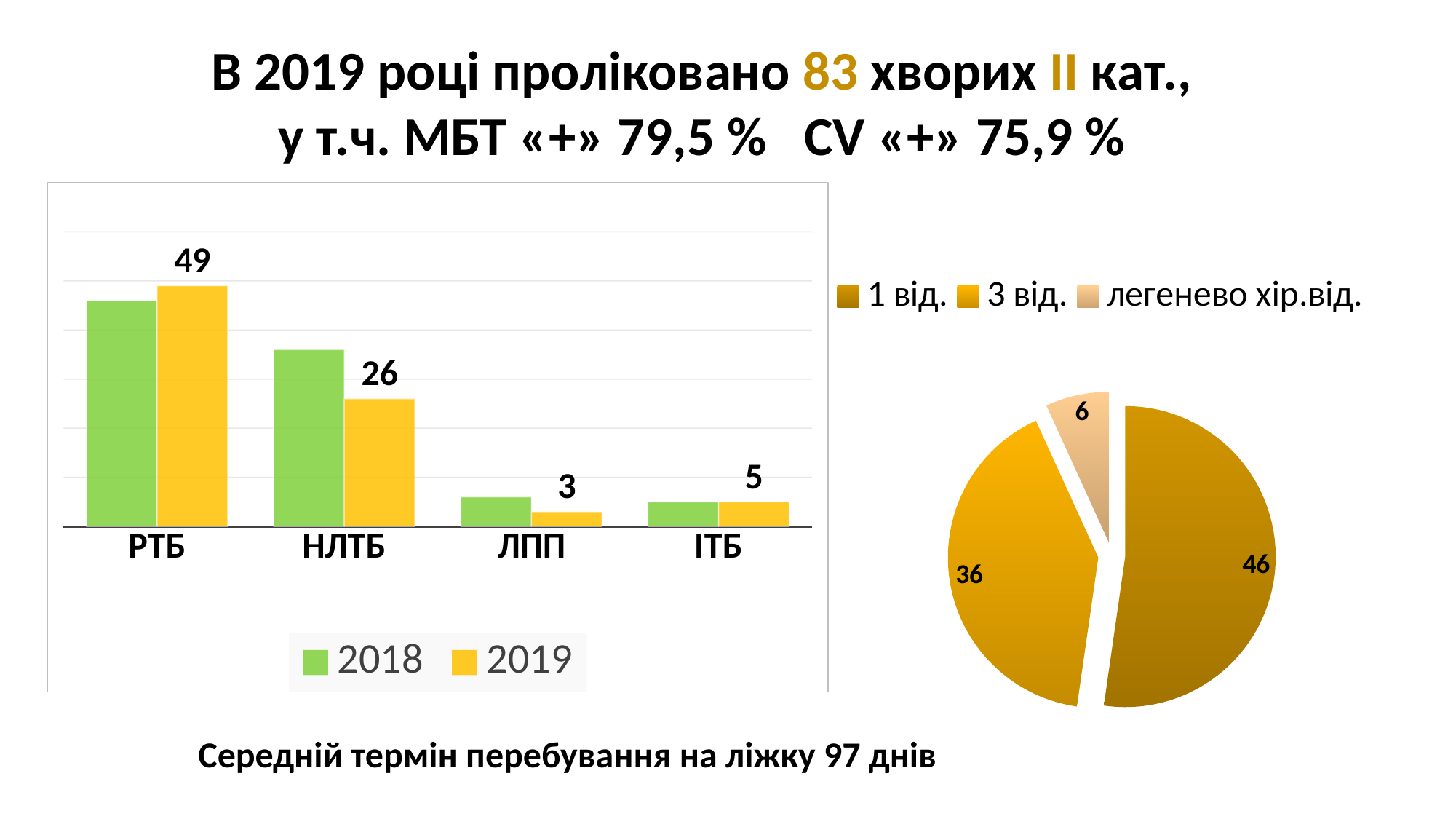
In the bar chart on the left, what is the 2019 value for ЛПП? 3 In the pie chart on the right, what is the value for 3 від.? 36 In the bar chart on the left, what is the 2019 value for РТБ? 49 In the bar chart on the left, for НЛТБ, which year has the larger value, 2018 or 2019? 2018 In the bar chart on the left, which category has the highest 2019 value? РТБ In the bar chart on the left, what is the 2019 value for НЛТБ? 26 In the bar chart on the left, for РТБ, which year has the larger value, 2018 or 2019? 2019 In the bar chart on the left, which category has the lowest 2019 value? ЛПП In the pie chart on the right, which category has the smallest slice? легенево хір.від. What kind of chart is the chart on the right of the slide? Pie chart How many series does the legend of the bar chart on the left list? 2 In the bar chart on the left, what is the difference between the 2019 values for РТБ and НЛТБ? 23